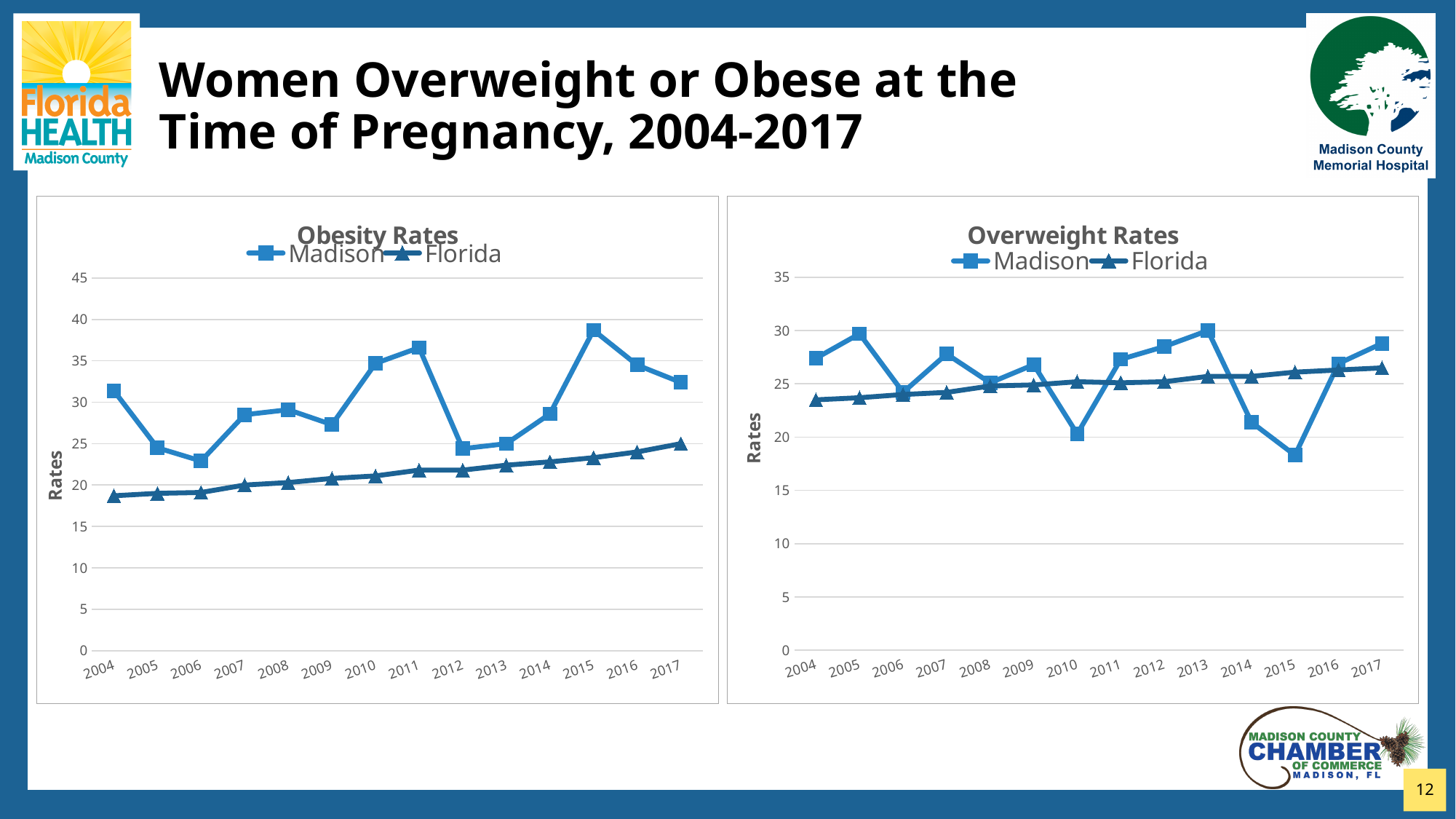
What is the title of the chart on the right side of the slide? Overweight Rates What kind of chart is the Obesity Rates chart? line chart In the Obesity Rates chart, which year has the highest Madison value? 2015 In the Overweight Rates chart, is the Madison value for 2015 greater or less than 20? less In the Obesity Rates chart, does the Florida series rise or fall from 2004 to 2017? rise In the Obesity Rates chart, is the Florida value for 2004 greater or less than 20? less How many years are plotted on the x axis of the Obesity Rates chart? 14 In the Overweight Rates chart, which is larger in 2014, Madison or Florida? Florida In the Obesity Rates chart, is the Madison value for 2015 greater or less than 35? greater How many series does the legend of the Overweight Rates chart list? 2 In the Overweight Rates chart, which year has the lowest Madison value? 2015 In the Obesity Rates chart, which year has the lowest Madison value? 2006